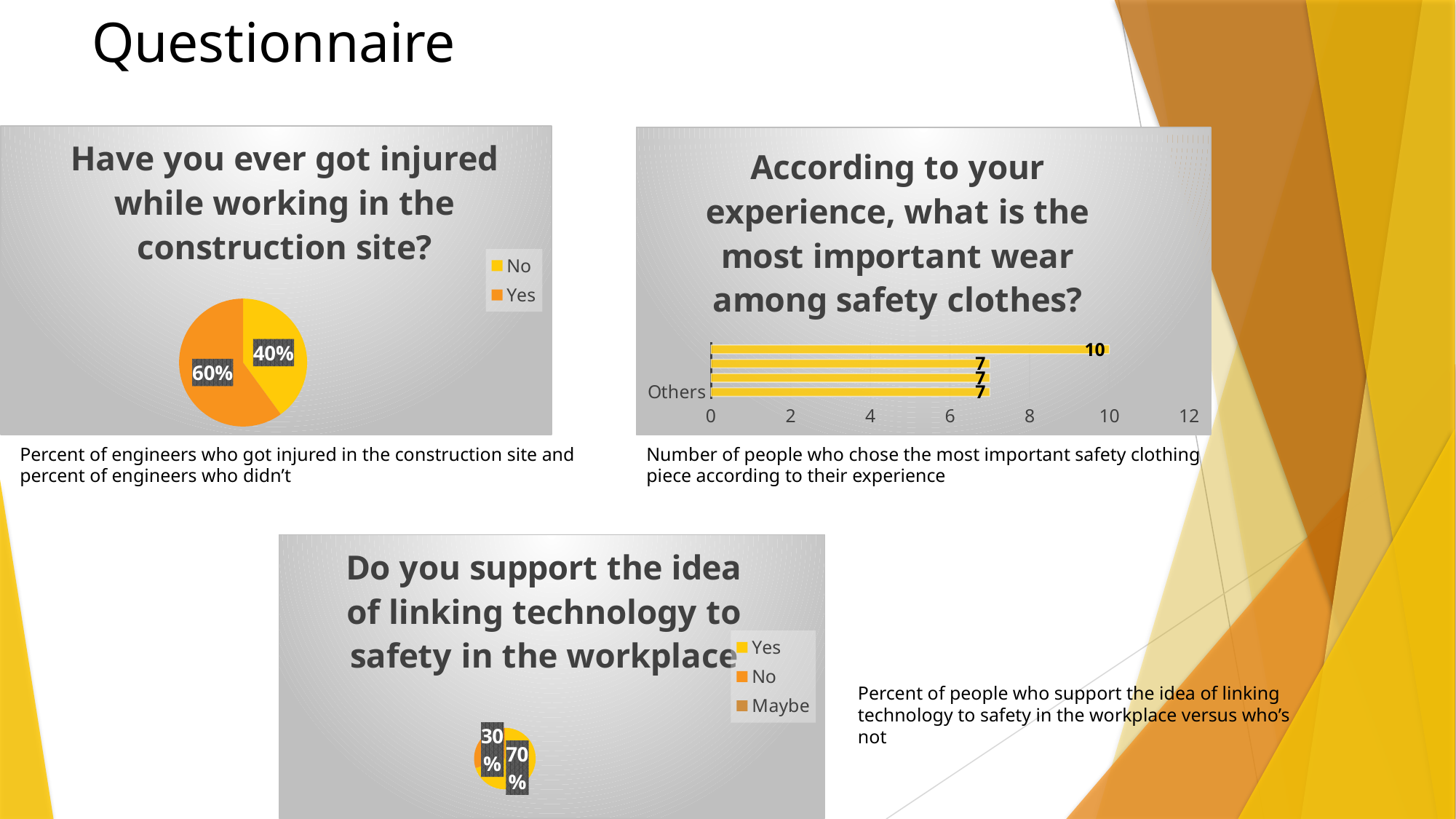
How many entries does the legend list in the chart titled "Do you support the idea of linking technology to safety in the workplace"? 3 In the chart titled "Have you ever got injured while working in the construction site?", what percentage is shown for "Yes"? 60% In the chart titled "According to your experience, what is the most important wear among safety clothes?", what is the value for "Others"? 7 In the chart titled "Have you ever got injured while working in the construction site?", what is the difference in percentage points between Yes and No? 20% How many entries does the legend list in the chart titled "Have you ever got injured while working in the construction site?"? 2 What kind of chart is the one titled "According to your experience, what is the most important wear among safety clothes?"? Bar chart In the chart titled "According to your experience, what is the most important wear among safety clothes?", what is the highest value shown on any bar? 10 In the chart titled "Have you ever got injured while working in the construction site?", which answer has the larger share, Yes or No? Yes In the chart titled "According to your experience, what is the most important wear among safety clothes?", is the value for "Others" greater or less than 8? less In the chart titled "Have you ever got injured while working in the construction site?", what percentage is shown for "No"? 40% What kind of chart is the one titled "Have you ever got injured while working in the construction site?"? Pie chart How many bars are plotted in the chart titled "According to your experience, what is the most important wear among safety clothes?"? 4